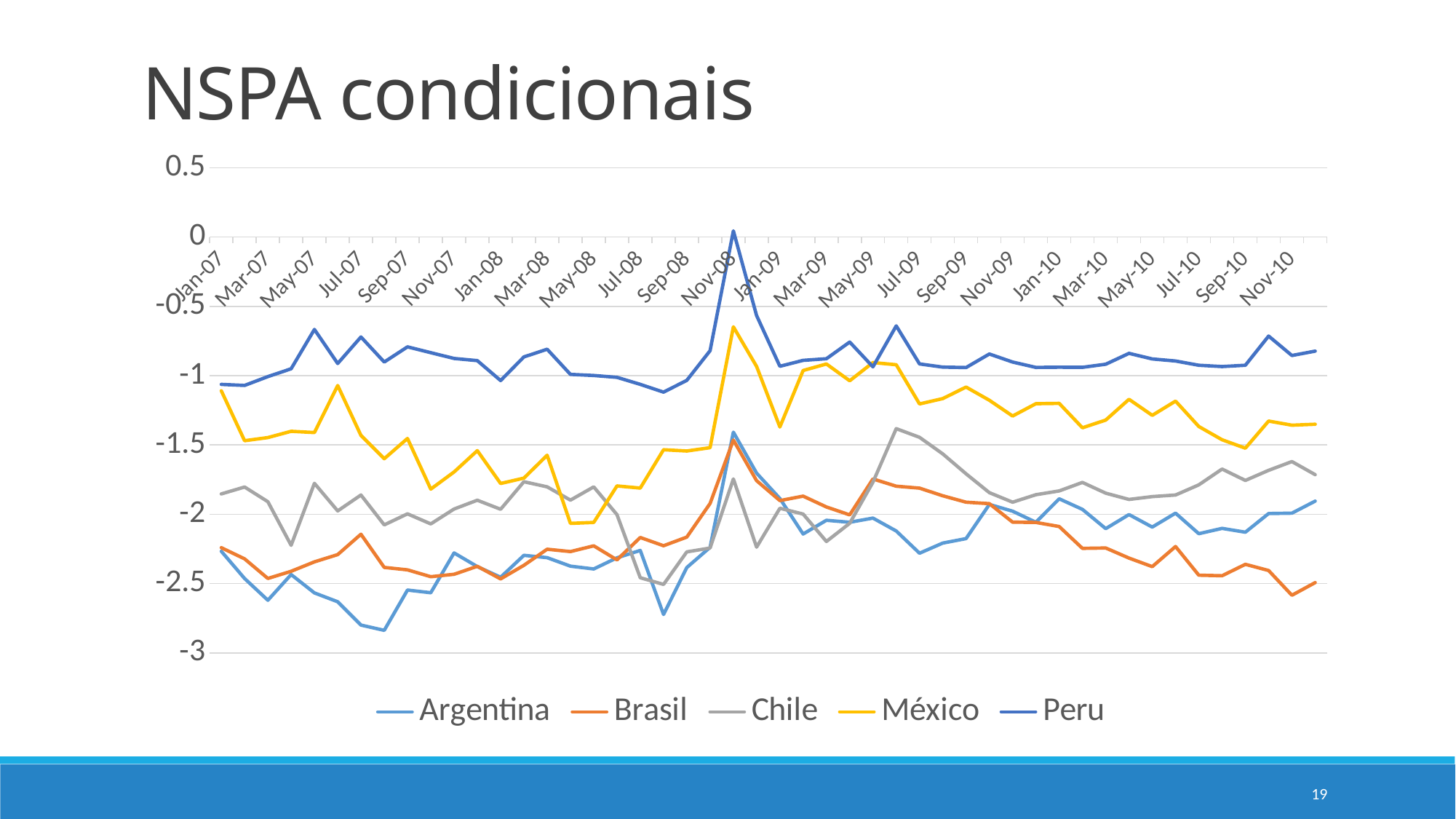
What is the title of the chart? NSPA condicionais Which series has the highest values across almost the whole period? Peru Which series is drawn in yellow? México How many series does the legend list? 5 Does the Brasil line generally rise or fall from Jul-09 to Nov-10? fall Is the value for Peru at Jul-09 greater or less than -1? greater Which is larger at Jan-08, the value for México or the value for Chile? México What kind of chart is shown on the slide? line chart Is the value for Argentina at Sep-07 greater or less than -2.5? less Is the value for Chile at Jul-09 greater or less than -1.5? greater Which is larger at Nov-10, the value for Argentina or the value for Brasil? Argentina Which series has the lowest value at Nov-10? Brasil